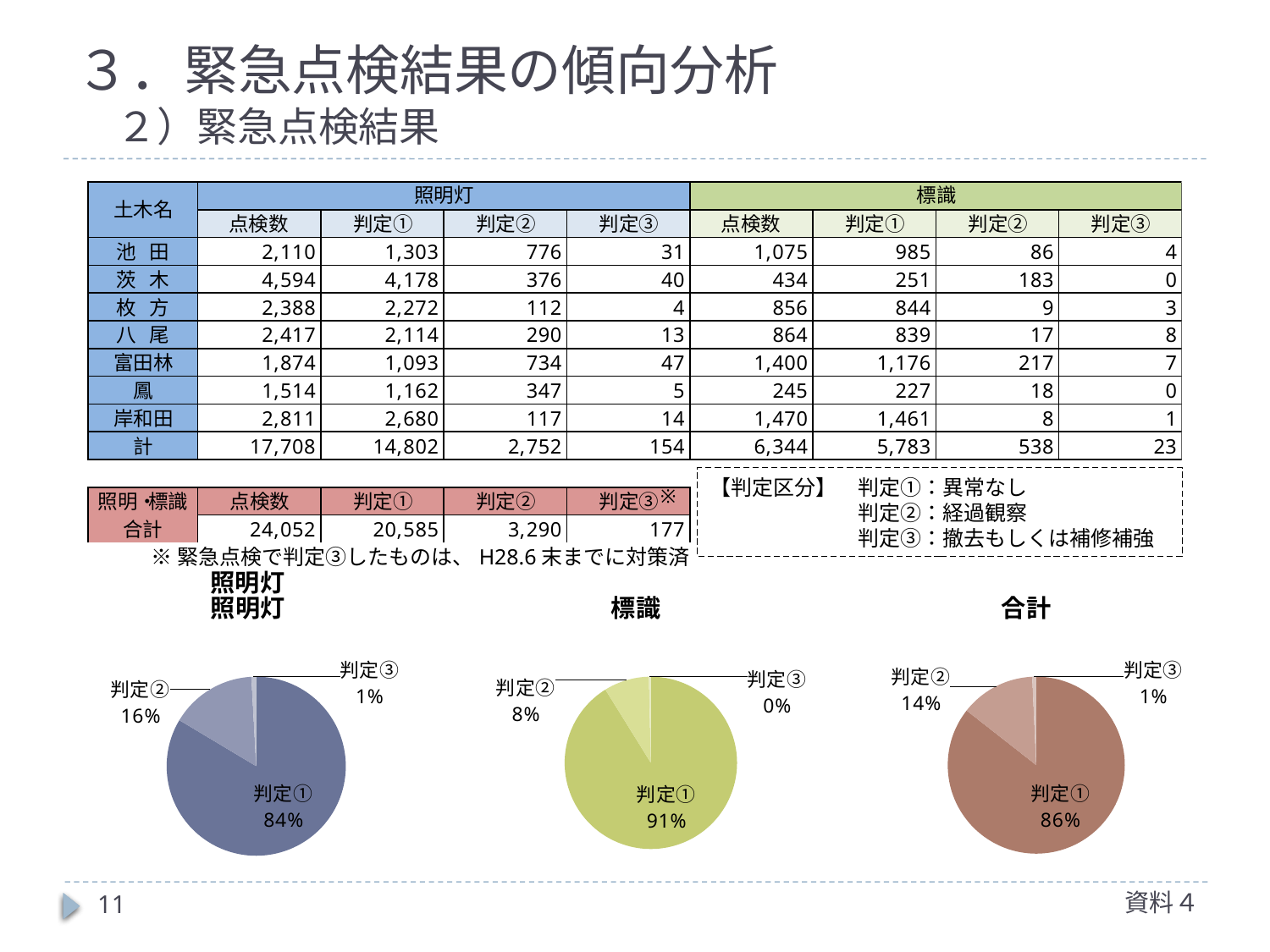
What kind of chart is used for 照明灯, 標識 and 合計 at the bottom of the slide? Pie chart In the 標識 pie chart, what share does 判定① have? 91% In the 合計 pie chart, what share does 判定③ have? 1% In the 照明灯 pie chart, what share does 判定② have? 16% In the 標識 pie chart, which category has the largest slice? 判定① What is the difference between the 判定① share in the 標識 pie chart and the 判定① share in the 照明灯 pie chart? 7% How many slices does the 合計 pie chart have? 3 Which is larger: the 判定② share in the 照明灯 pie chart or the 判定② share in the 標識 pie chart? 照明灯 In the 照明灯 pie chart, which category has the smallest slice? 判定③